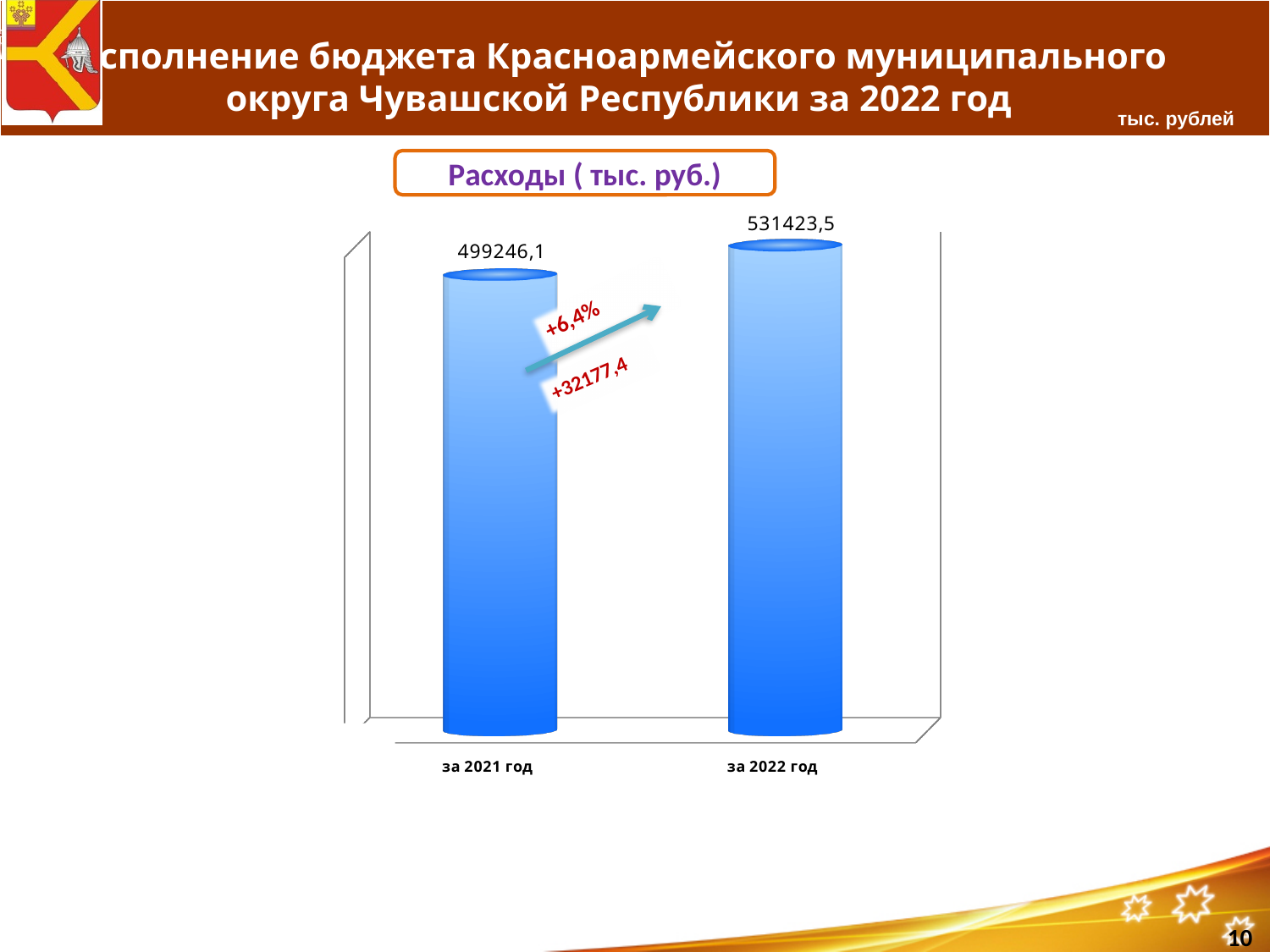
How many categories are shown in the chart? 2 Which category has the highest value? за 2022 год What is the difference between the values for за 2022 год and за 2021 год? 32177,4 Do the values rise or fall from за 2021 год to за 2022 год? rise What percentage change is annotated on the chart between the two bars? +6,4% Which category has the lowest value? за 2021 год What is the value for за 2022 год? 531423,5 What is the value for за 2021 год? 499246,1 What is the title of the chart? Расходы ( тыс. руб.) Which is larger, the value for за 2021 год or за 2022 год? за 2022 год What kind of chart is shown on the slide? bar chart